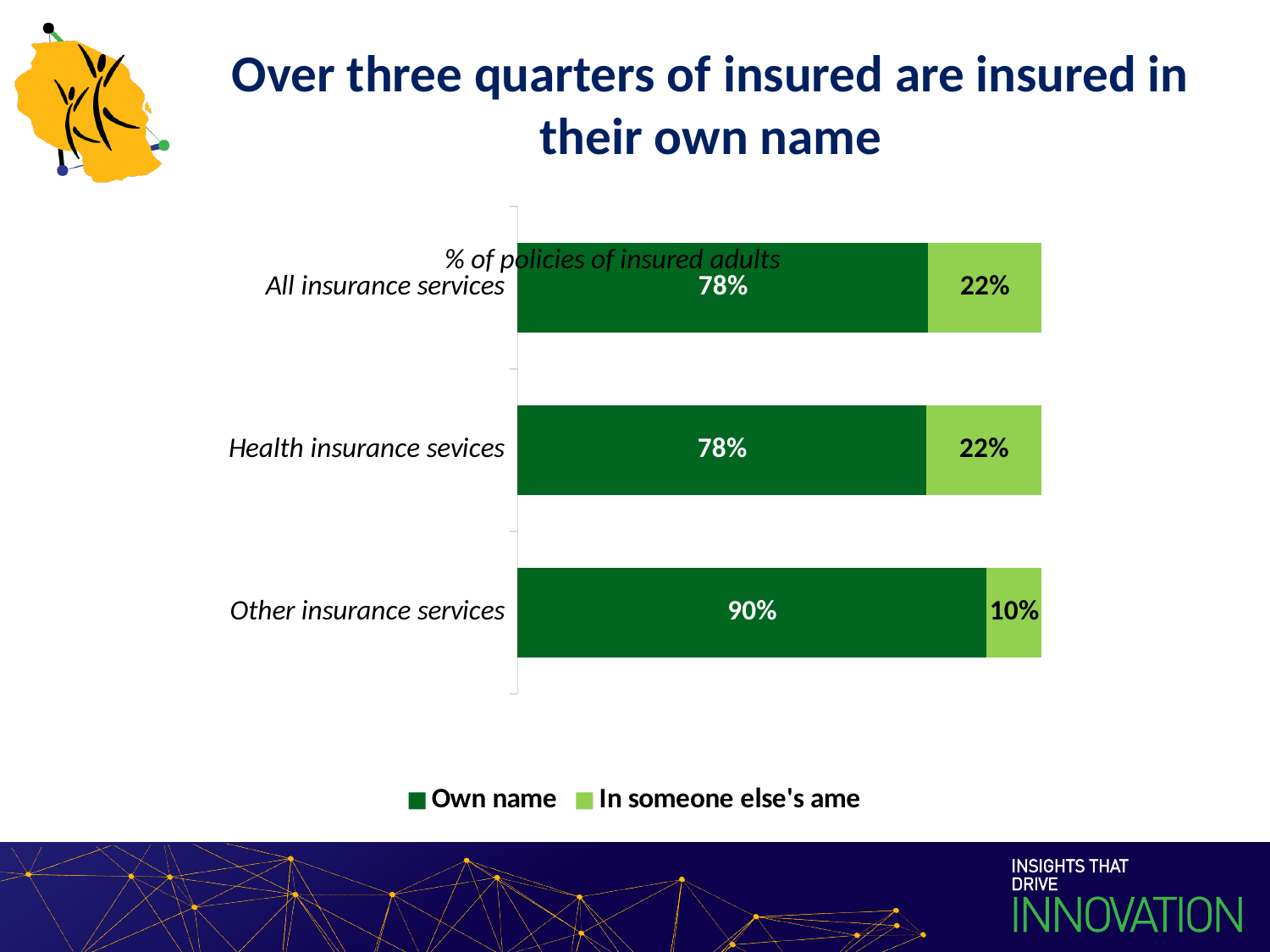
How many series does the legend list? 2 What is the difference between the 'Own name' values for Other insurance services and Health insurance sevices? 12% What is the 'In someone else's ame' value for Health insurance sevices? 22% How many categories are shown on the chart? 3 What is the 'In someone else's ame' value for Other insurance services? 10% What is the 'Own name' value for Other insurance services? 90% Which category has the lowest 'In someone else's ame' value? Other insurance services Which category has the highest 'Own name' value? Other insurance services What kind of chart is shown on the slide? Stacked bar chart What is the 'Own name' value for All insurance services? 78% What is the total of the stacked bar for Health insurance sevices? 100% Which is larger: the 'In someone else's ame' value for All insurance services or for Other insurance services? All insurance services